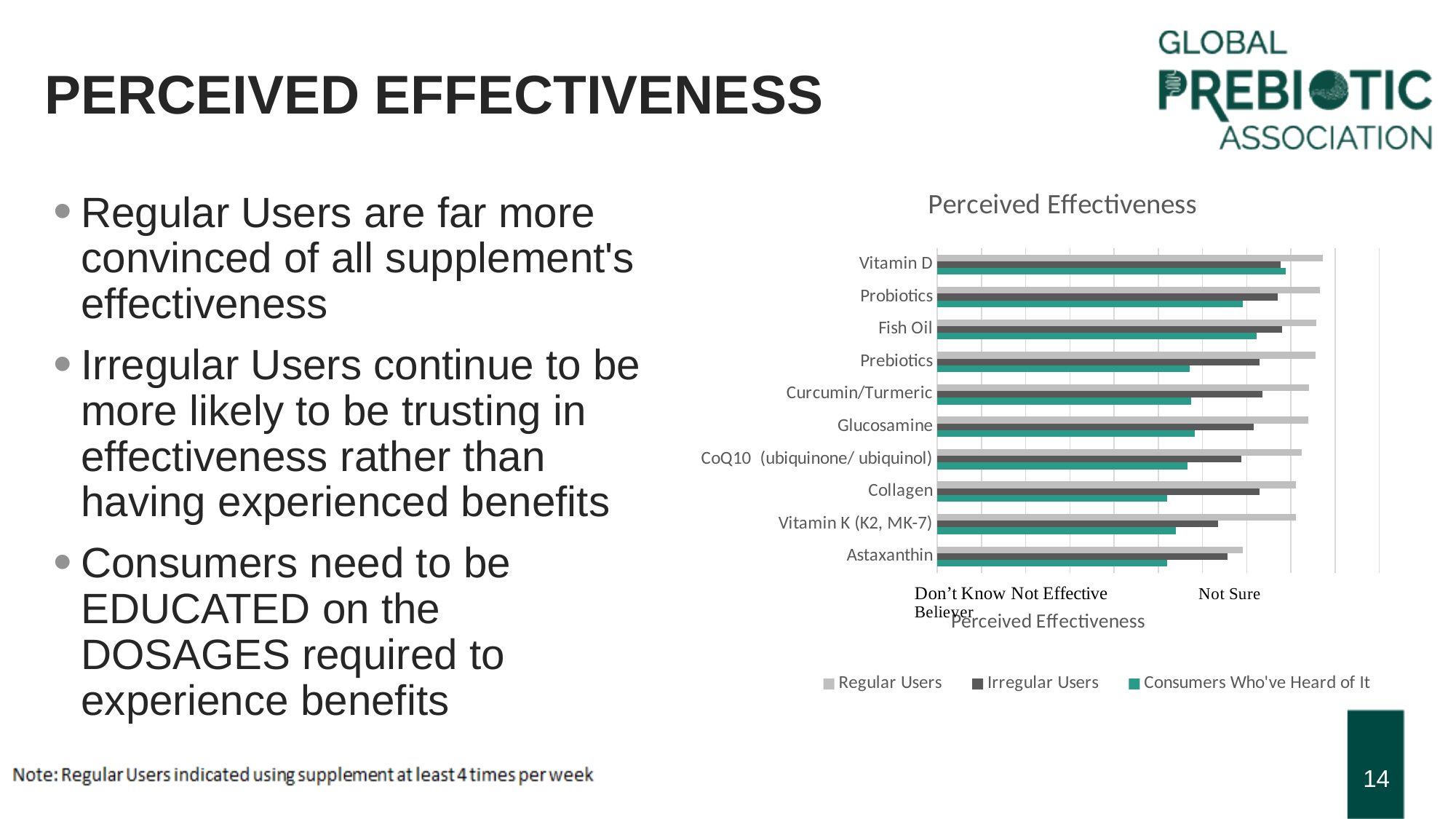
For Vitamin D, which is larger: the Regular Users bar or the Irregular Users bar? Regular Users Which supplement has the longest bar for Consumers Who've Heard of It? Vitamin D How many supplement categories are listed on the chart? 10 Which supplement has the shortest bar for Regular Users? Astaxanthin For Regular Users, which is larger: Fish Oil or Astaxanthin? Fish Oil How many series does the chart legend list? 3 For Collagen, which is larger: the Irregular Users bar or the Consumers Who've Heard of It bar? Irregular Users Which series is drawn in green on the chart? Consumers Who've Heard of It What kind of chart is shown on the slide? Bar chart What is the title of the chart? Perceived Effectiveness